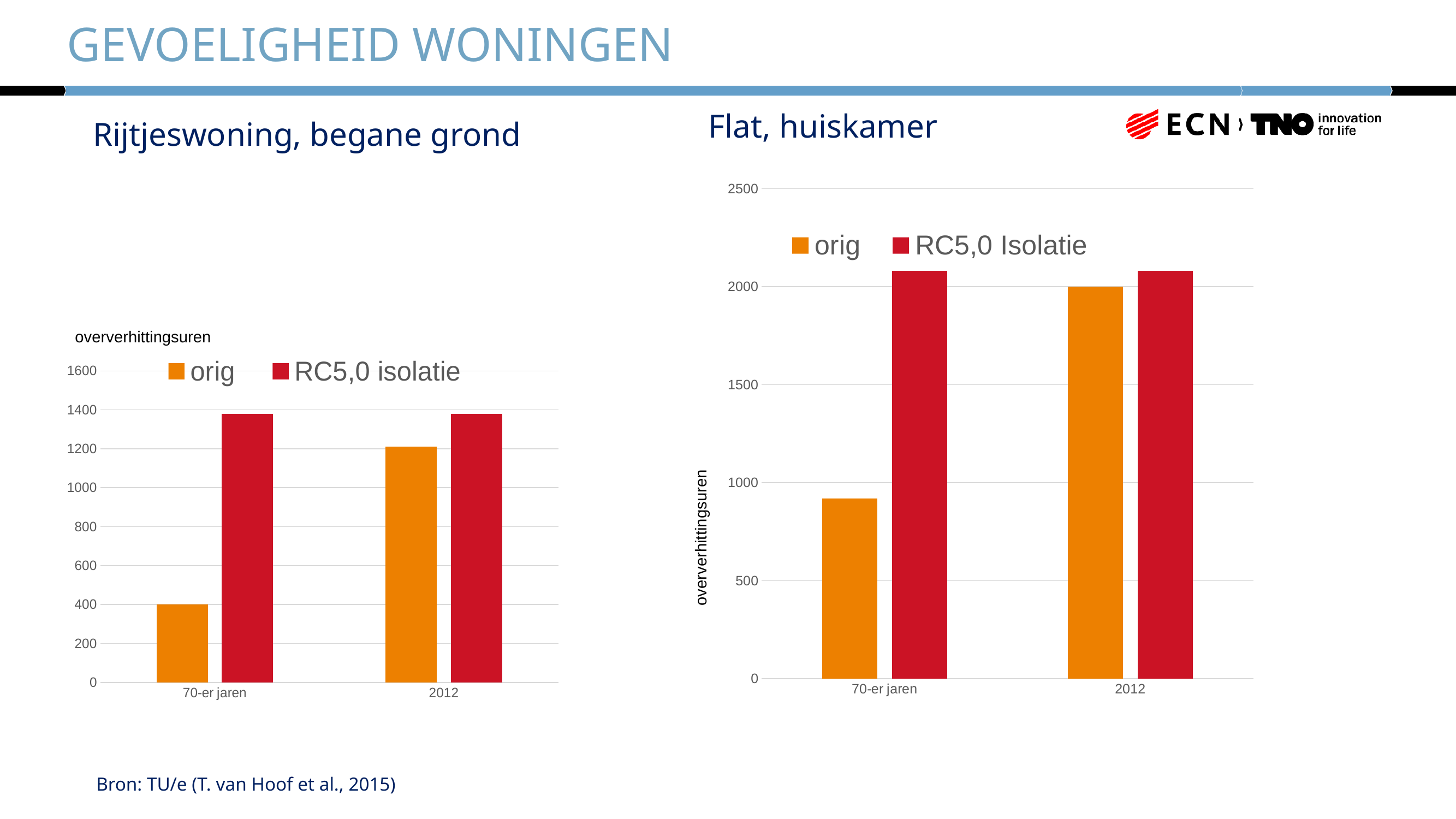
In the 'Rijtjeswoning, begane grond' chart, which bar is the lowest? orig, 70-er jaren In the 'Flat, huiskamer' chart, which is larger for 70-er jaren: orig or RC5,0 Isolatie? RC5,0 Isolatie What kind of chart is the 'Rijtjeswoning, begane grond' chart? bar chart In the 'Flat, huiskamer' chart, does the orig series rise or fall from 70-er jaren to 2012? rise In the 'Flat, huiskamer' chart, is the value for RC5,0 Isolatie in 70-er jaren greater or less than 2000? greater How many categories are shown on the x axis of the 'Rijtjeswoning, begane grond' chart? 2 How many series does the legend of the 'Flat, huiskamer' chart list? 2 In the 'Rijtjeswoning, begane grond' chart, is the value for orig in 2012 greater or less than 1000? greater In the 'Rijtjeswoning, begane grond' chart, is the value for orig in 70-er jaren greater or less than 600? less What is the label of the vertical axis in the 'Flat, huiskamer' chart? oververhittingsuren In the 'Rijtjeswoning, begane grond' chart, which is larger for 70-er jaren: orig or RC5,0 isolatie? RC5,0 isolatie